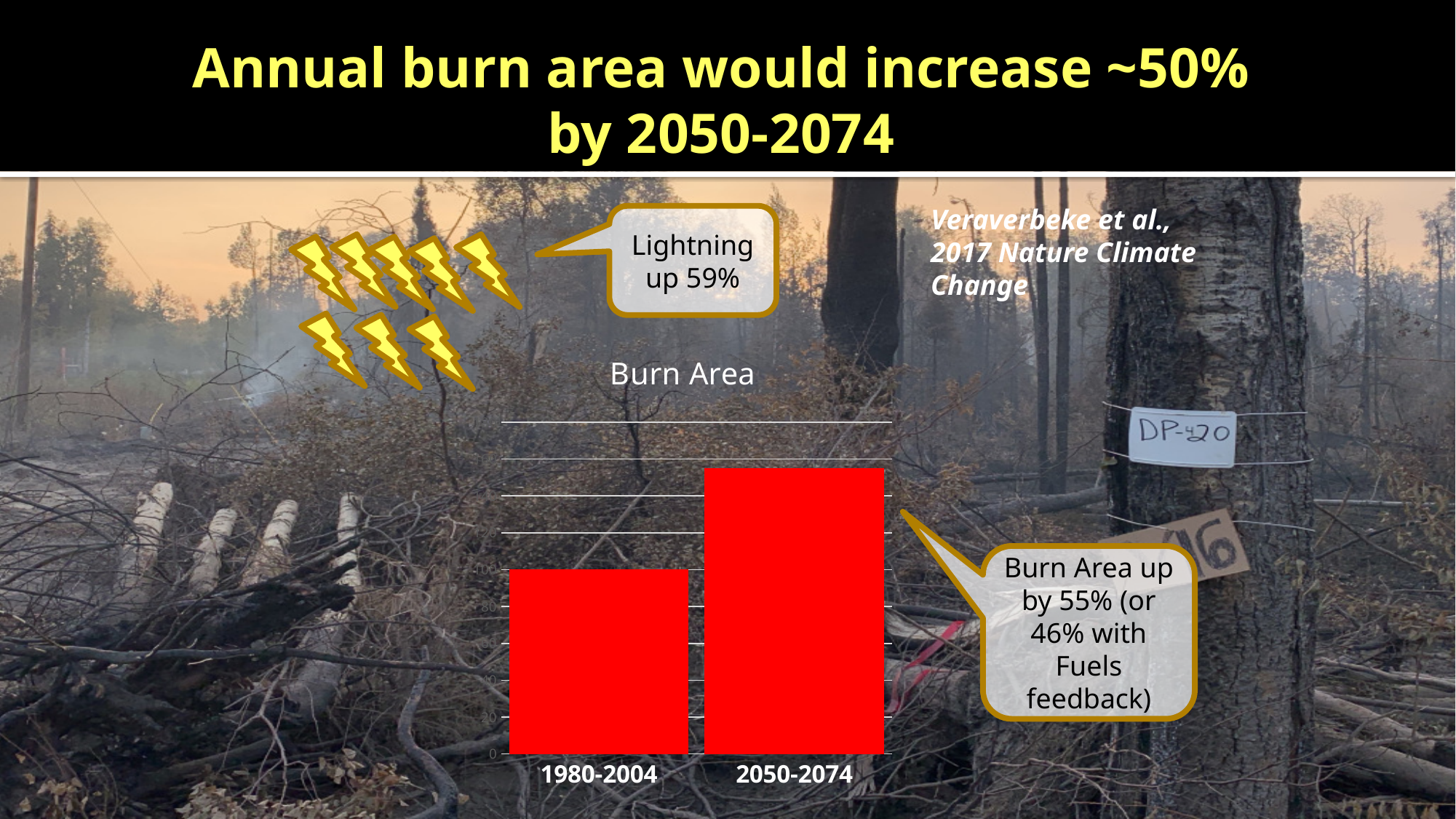
What colour are the bars in the Burn Area chart? red Which is larger in the Burn Area chart, the value for 1980-2004 or the value for 2050-2074? 2050-2074 Which period has the highest burn area in the chart? 2050-2074 Is the value for 1980-2004 in the Burn Area chart greater or less than 120? less What is the title of the chart? Burn Area Is the value for 2050-2074 in the Burn Area chart greater or less than 140? greater Is the value for 2050-2074 in the Burn Area chart greater or less than 120? greater How many categories are shown on the x axis of the Burn Area chart? 2 Which period has the lowest burn area in the chart? 1980-2004 Do the values in the Burn Area chart rise or fall from 1980-2004 to 2050-2074? rise What kind of chart is shown on the slide? bar chart What value does the 1980-2004 bar reach on the y axis of the Burn Area chart? 100